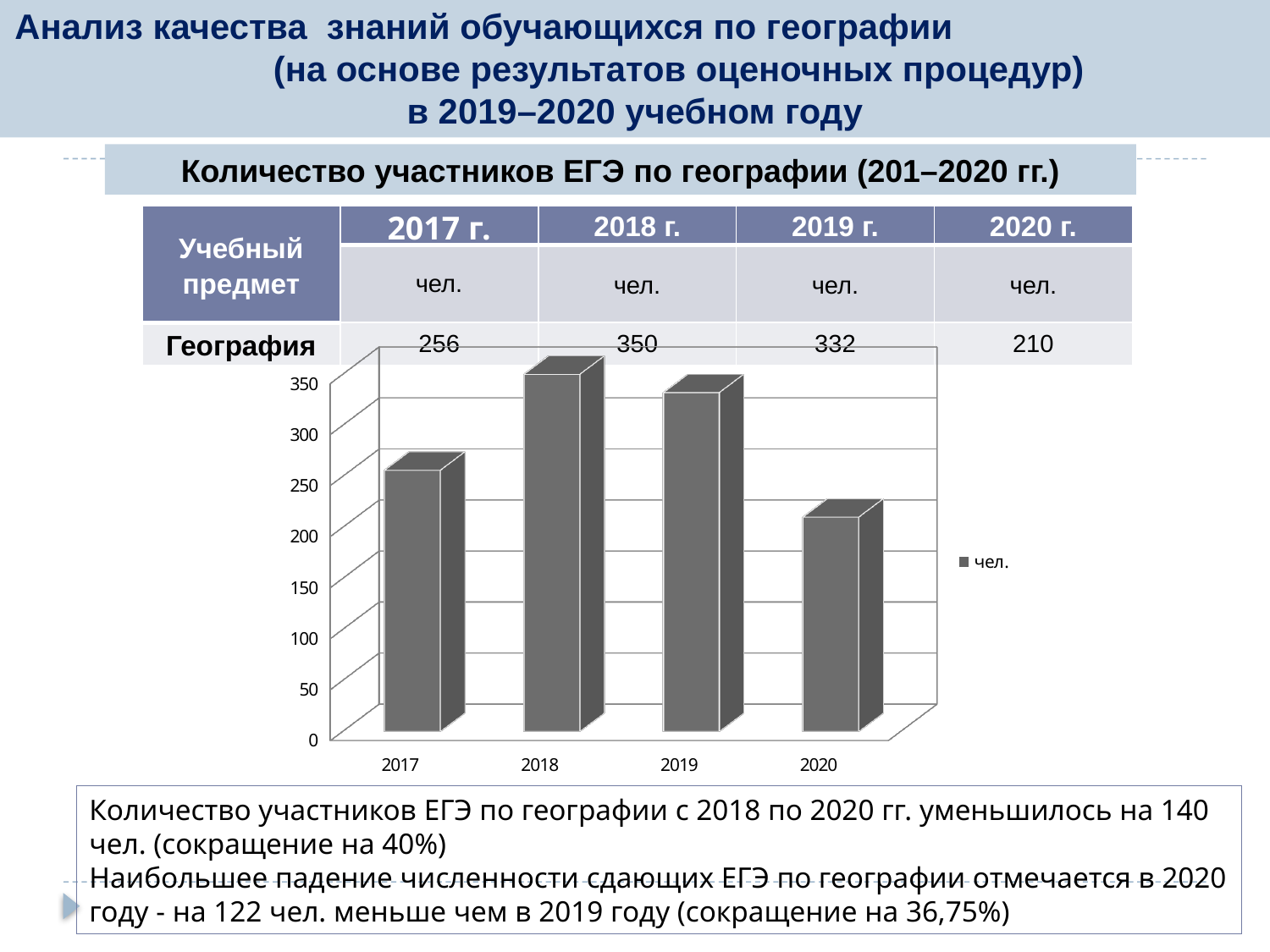
Which year has the lowest number of EGE geography participants in the chart? 2020 What is the number of participants (чел.) for 2018? 350 What kind of chart is shown on the slide? bar chart Which year has the highest number of EGE geography participants in the chart? 2018 From 2018 to 2020, do the values in the chart rise or fall? fall What is the number of participants (чел.) for 2020? 210 Which year has more participants, 2017 or 2019? 2019 How many series does the chart legend list? 1 What is the difference between the number of participants in 2018 and in 2020? 140 Is the value for 2020 greater or less than 250? less What is the legend entry of the chart? чел. How many years (categories) are plotted on the x axis of the chart? 4